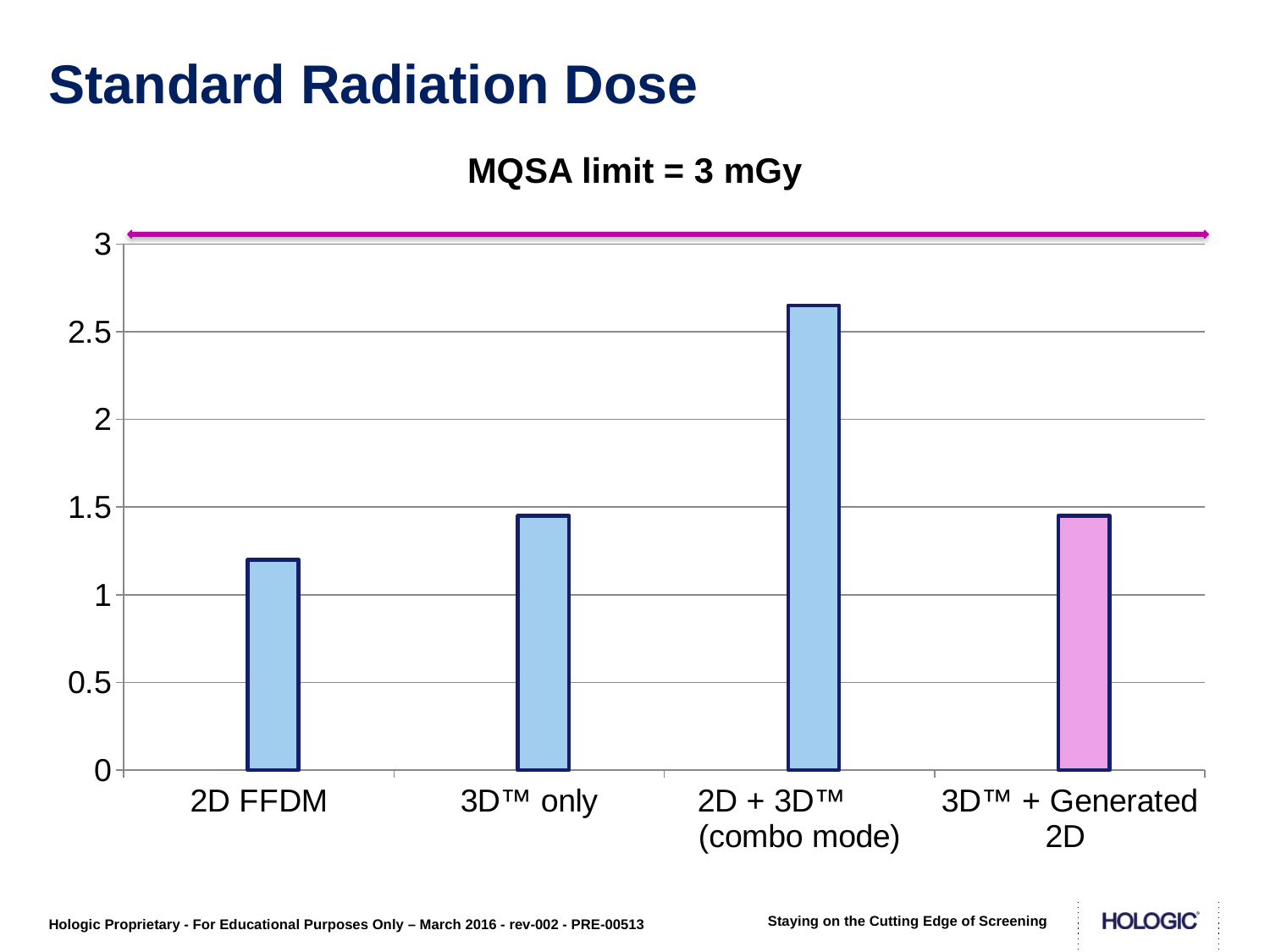
Which category has the highest value? 2D + 3D™ (combo mode) Is the value for 2D + 3D™ (combo mode) greater or less than 3? less What kind of chart is shown on the slide? bar chart Is the value for 2D + 3D™ (combo mode) greater or less than 2.5? greater Is the value for 3D™ only greater or less than 1? greater What MQSA limit is stated above the chart? 3 mGy Which is larger, the value for 2D FFDM or the value for 2D + 3D™ (combo mode)? 2D + 3D™ (combo mode) How many categories are plotted on the chart? 4 Which category has the lowest value? 2D FFDM